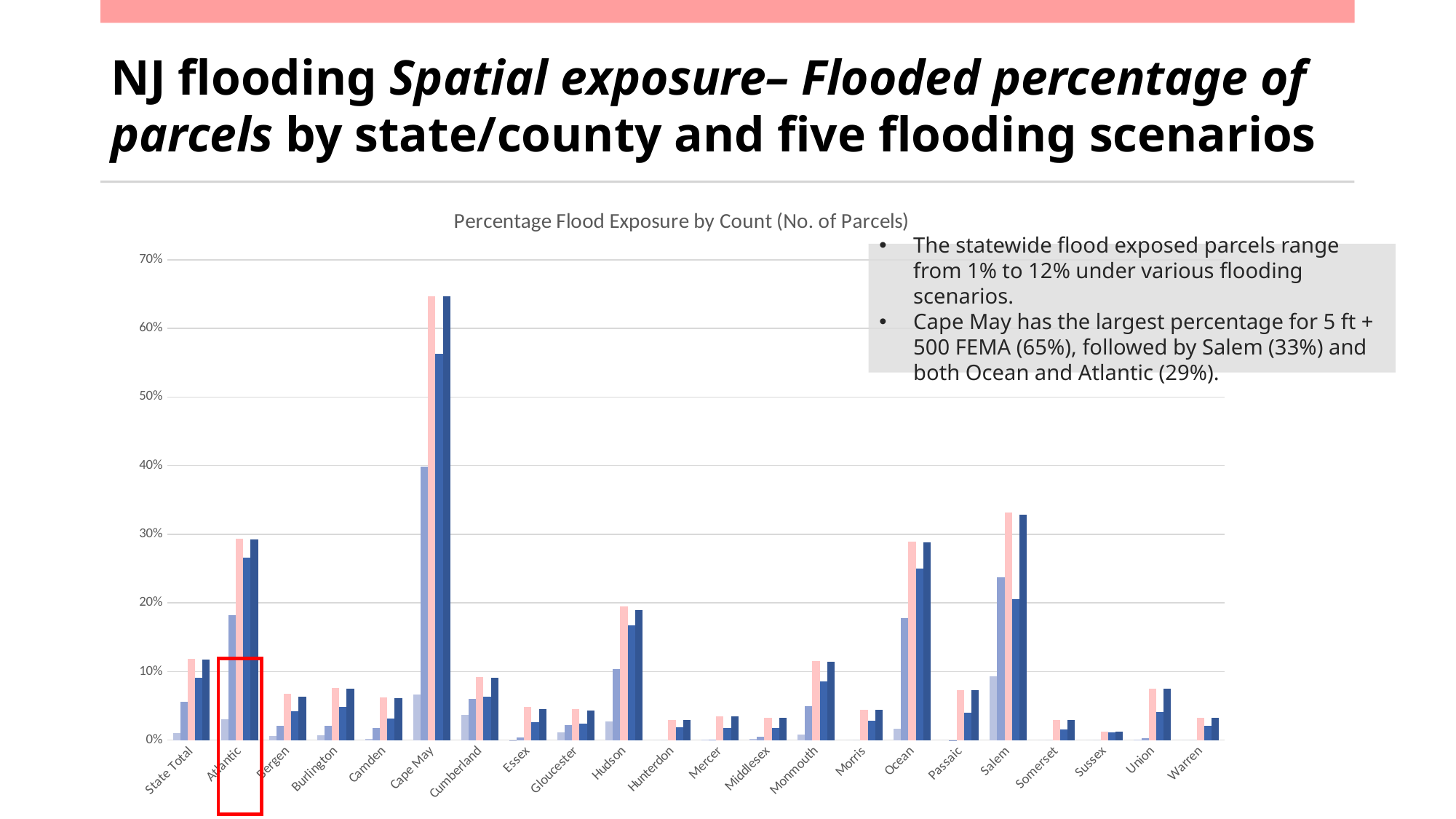
Is the tallest bar for Hudson greater or less than 10%? greater Which category on the x axis is outlined with a red box? Atlantic Is the tallest bar for Hunterdon greater or less than 10%? less How many bars are plotted for each category in the chart? 5 Which category has the tallest bar in the chart? Cape May Which has the taller tallest bar, Hudson or Monmouth? Hudson Which has the taller tallest bar, Cape May or Salem? Cape May How many categories are shown along the x axis of the chart? 22 What is the title of the chart? Percentage Flood Exposure by Count (No. of Parcels) Is the tallest bar for Cape May greater or less than 60%? greater What kind of chart is shown on the slide? bar chart